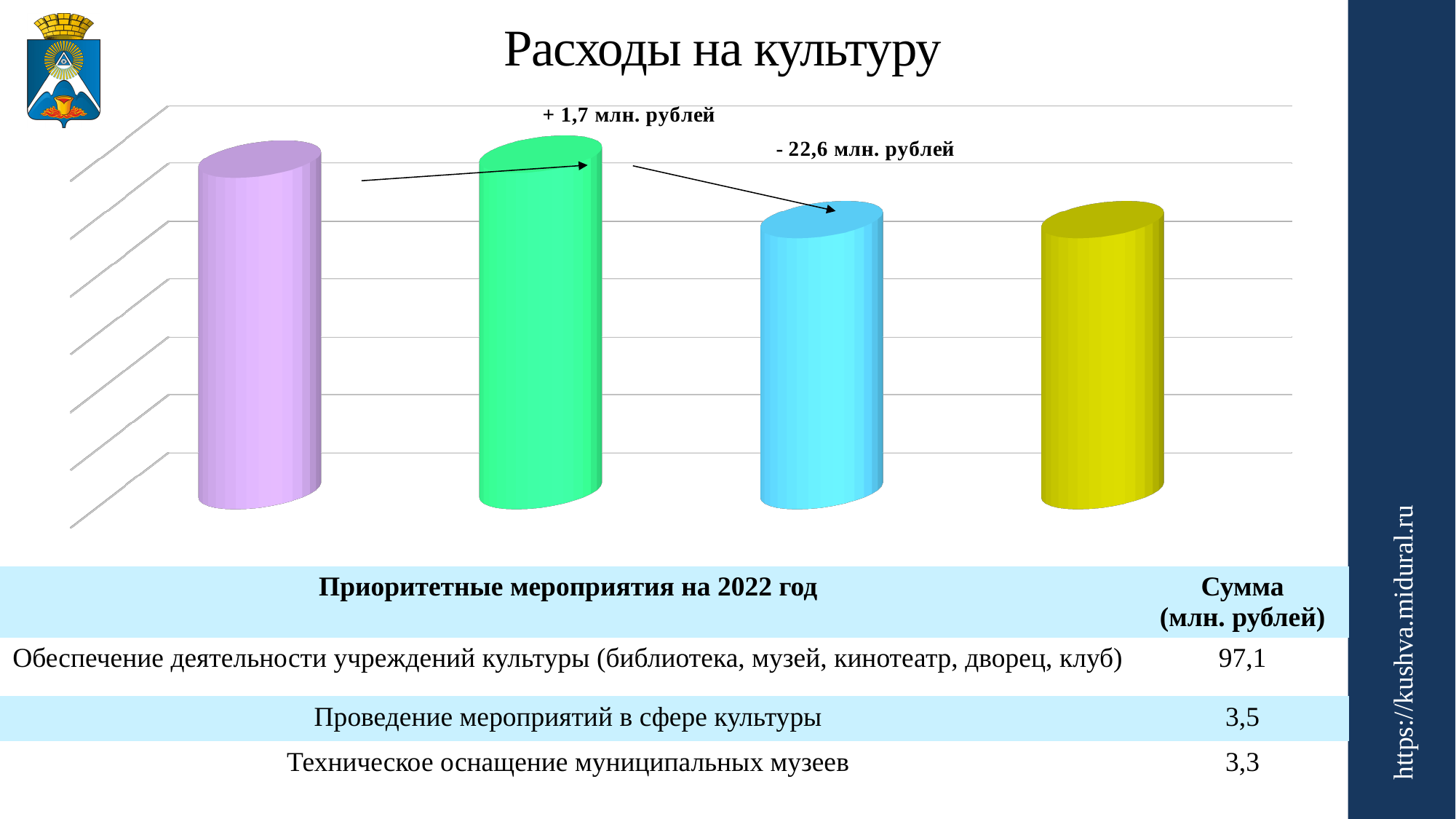
What colour is the tallest bar in the chart? green What is the title of the chart on the slide? Расходы на культуру Which is taller, the second (green) bar or the fourth (yellow) bar? the second (green) bar What kind of chart is shown on the slide? bar chart Which bar is the tallest in the chart: the first, second, third or fourth? second What change is annotated on the arrow from the second bar to the third bar? - 22,6 млн. рублей How many bars are plotted in the chart? 4 Do the bars rise or fall from the second bar to the third bar? fall Which is taller, the first (purple) bar or the third (blue) bar? the first (purple) bar What change is annotated on the arrow from the first bar to the second bar? + 1,7 млн. рублей